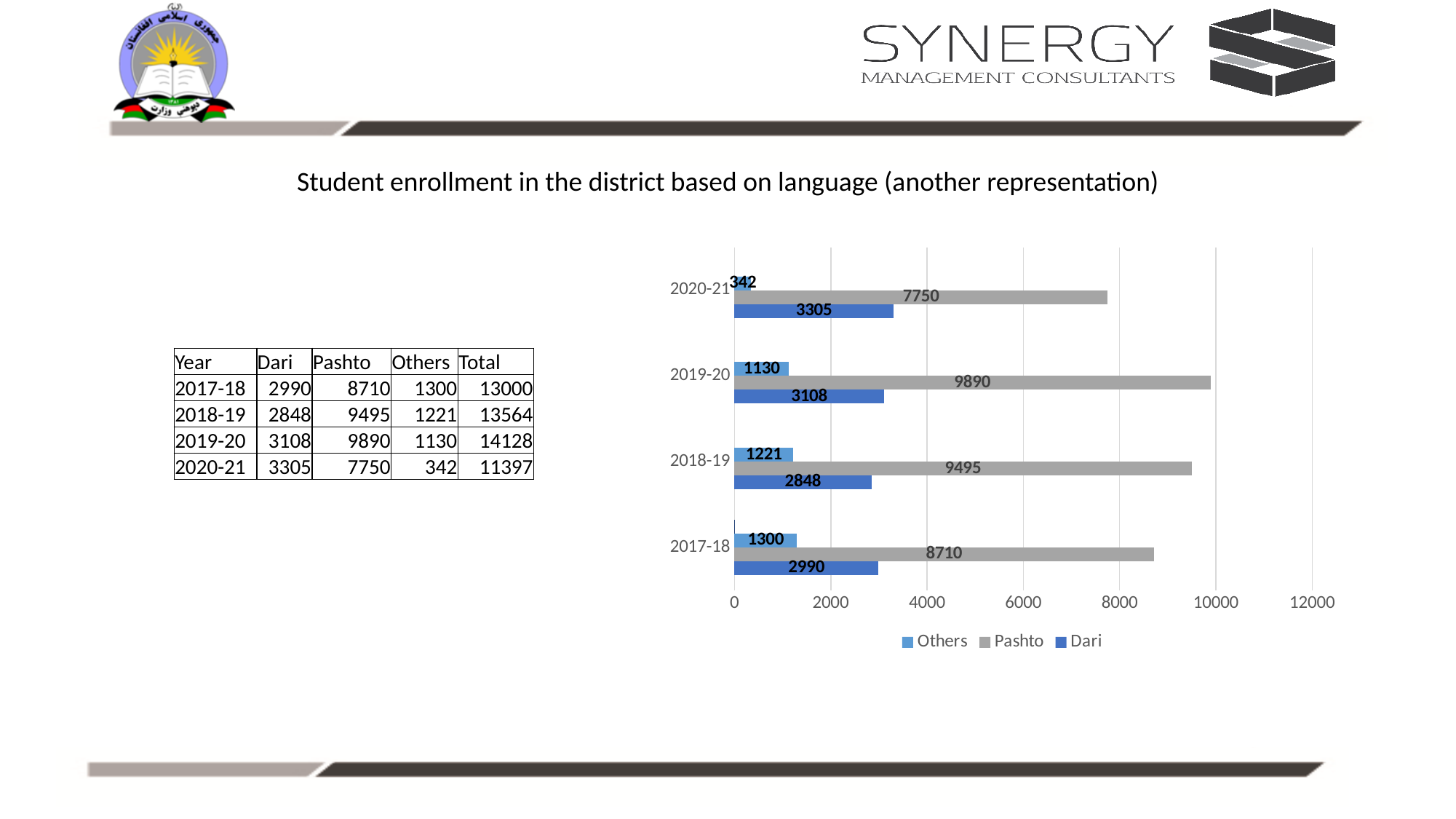
How many years are shown on the chart's vertical axis? 4 What is the Others enrollment value for 2017-18 in the chart? 1300 Which year has the lowest Others enrollment in the chart? 2020-21 What is the Pashto enrollment value for 2019-20 in the chart? 9890 What kind of chart is shown on the slide? Bar chart What is the difference between the Pashto values for 2019-20 and 2020-21? 2140 Which is larger, the Dari value for 2017-18 or the Dari value for 2018-19? 2017-18 Which year has the highest Pashto enrollment in the chart? 2019-20 Is the Pashto value for 2017-18 greater or less than 8000? greater Which series is shown in grey in the chart? Pashto What is the Dari enrollment value for 2020-21 in the chart? 3305 How many series does the chart legend list? 3